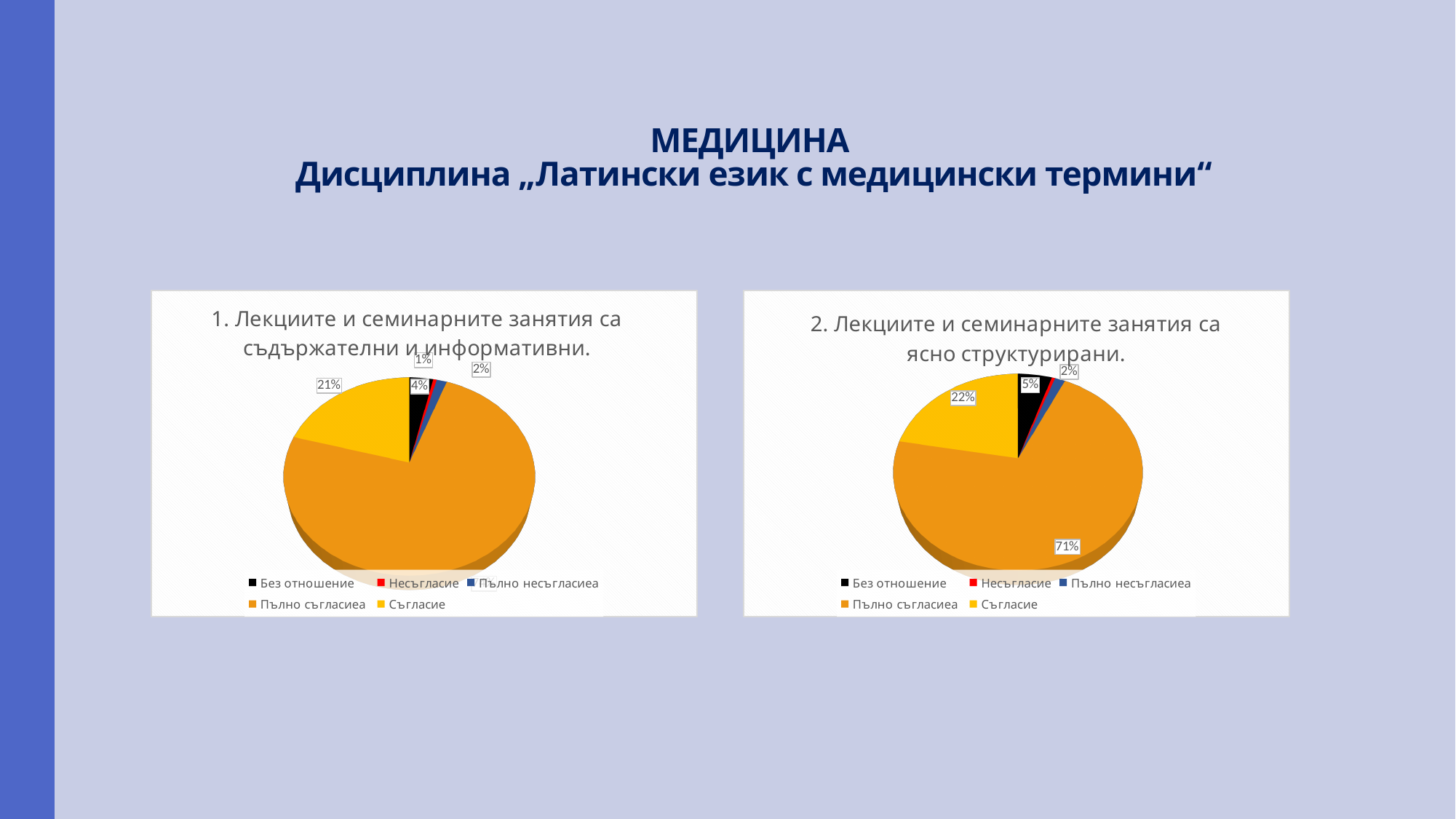
In the right chart ("2. Лекциите и семинарните занятия са ясно структурирани."), which category has the largest share? Пълно съгласиеа In the right chart ("2. Лекциите и семинарните занятия са ясно структурирани."), what percentage is shown for "Пълно съгласиеа"? 71% In the right chart ("2. Лекциите и семинарните занятия са ясно структурирани."), what is the difference between the shares of "Пълно съгласиеа" and "Съгласие"? 49% In the right chart ("2. Лекциите и семинарните занятия са ясно структурирани."), what percentage is shown for "Съгласие"? 22% What type of chart is used in the left chart titled "1. Лекциите и семинарните занятия са съдържателни и информативни."? Pie chart In the left chart ("1. Лекциите и семинарните занятия са съдържателни и информативни."), which category has the smallest share? Несъгласие In the left chart ("1. Лекциите и семинарните занятия са съдържателни и информативни."), what percentage is shown for "Без отношение"? 4% In the left chart ("1. Лекциите и семинарните занятия са съдържателни и информативни."), what percentage is shown for "Пълно несъгласиеа"? 2% In the right chart ("2. Лекциите и семинарните занятия са ясно структурирани."), which is larger: the share for "Без отношение" or the share for "Пълно несъгласиеа"? Без отношение In the left chart ("1. Лекциите и семинарните занятия са съдържателни и информативни."), what percentage is shown for "Съгласие"? 21% How many categories does the legend of the left chart ("1. Лекциите и семинарните занятия са съдържателни и информативни.") list? 5 In the right chart ("2. Лекциите и семинарните занятия са ясно структурирани."), what percentage is shown for "Без отношение"? 5%